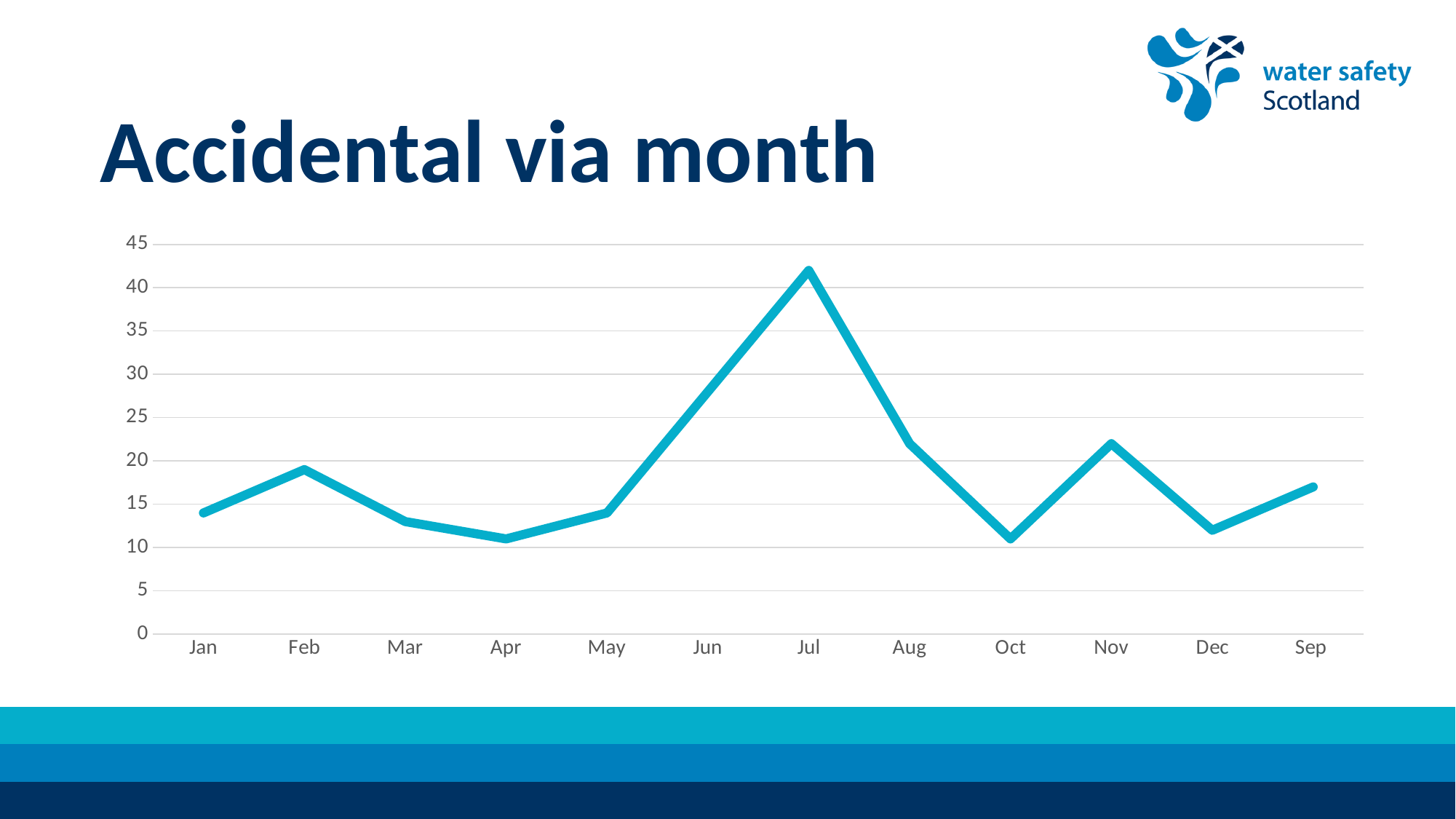
Which month has the highest value? Jul Which is larger, the value for Jul or the value for Jun? Jul Is the value for Jul greater or less than 40? greater What kind of chart is shown on the slide? line chart How many months are plotted along the x axis? 12 Do the values rise or fall from May to Jul? rise Is the value for Jun greater or less than 25? greater Which month label appears last on the x axis? Sep Which is larger, the value for Nov or the value for Dec? Nov What is the title of the chart? Accidental via month Is the value for Mar greater or less than 15? less